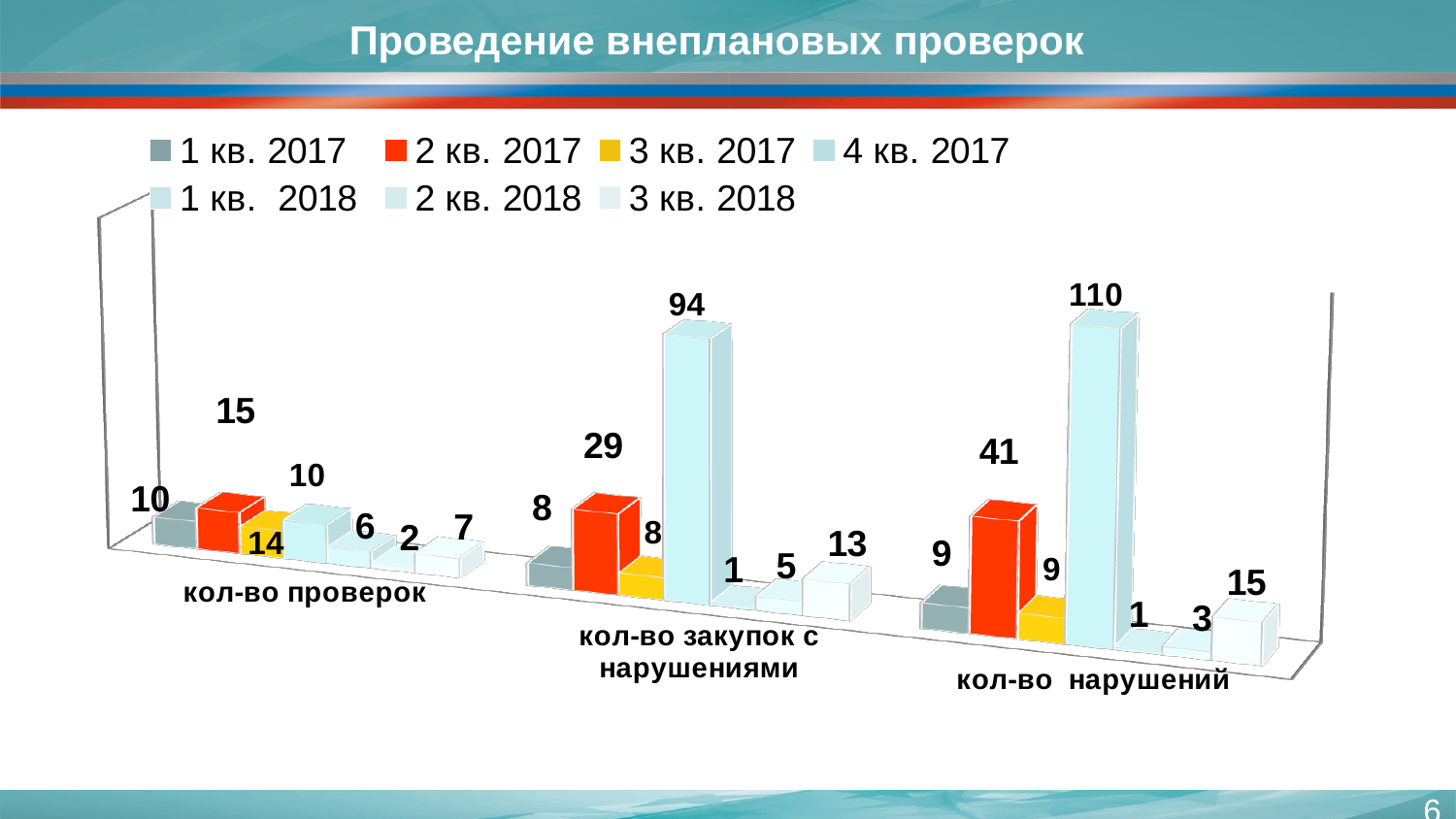
What is the difference between the 4 кв. 2017 values for кол-во нарушений and кол-во закупок с нарушениями? 16 What is the title of the chart? Проведение внеплановых проверок What is the value for 3 кв. 2018 in the category кол-во проверок? 7 What is the value for 2 кв. 2017 in the category кол-во закупок с нарушениями? 29 How many series does the legend list? 7 What is the difference between the 2 кв. 2017 and 1 кв. 2017 values in the category кол-во проверок? 5 Which series has the lowest value in the category кол-во проверок? 2 кв. 2018 What kind of chart is shown on the slide? bar chart How many categories are shown on the x axis? 3 Which series has the highest value in the category кол-во закупок с нарушениями? 4 кв. 2017 What is the value for 4 кв. 2017 in the category кол-во нарушений? 110 Which is larger in the category кол-во нарушений: the value for 2 кв. 2017 or the value for 3 кв. 2018? 2 кв. 2017